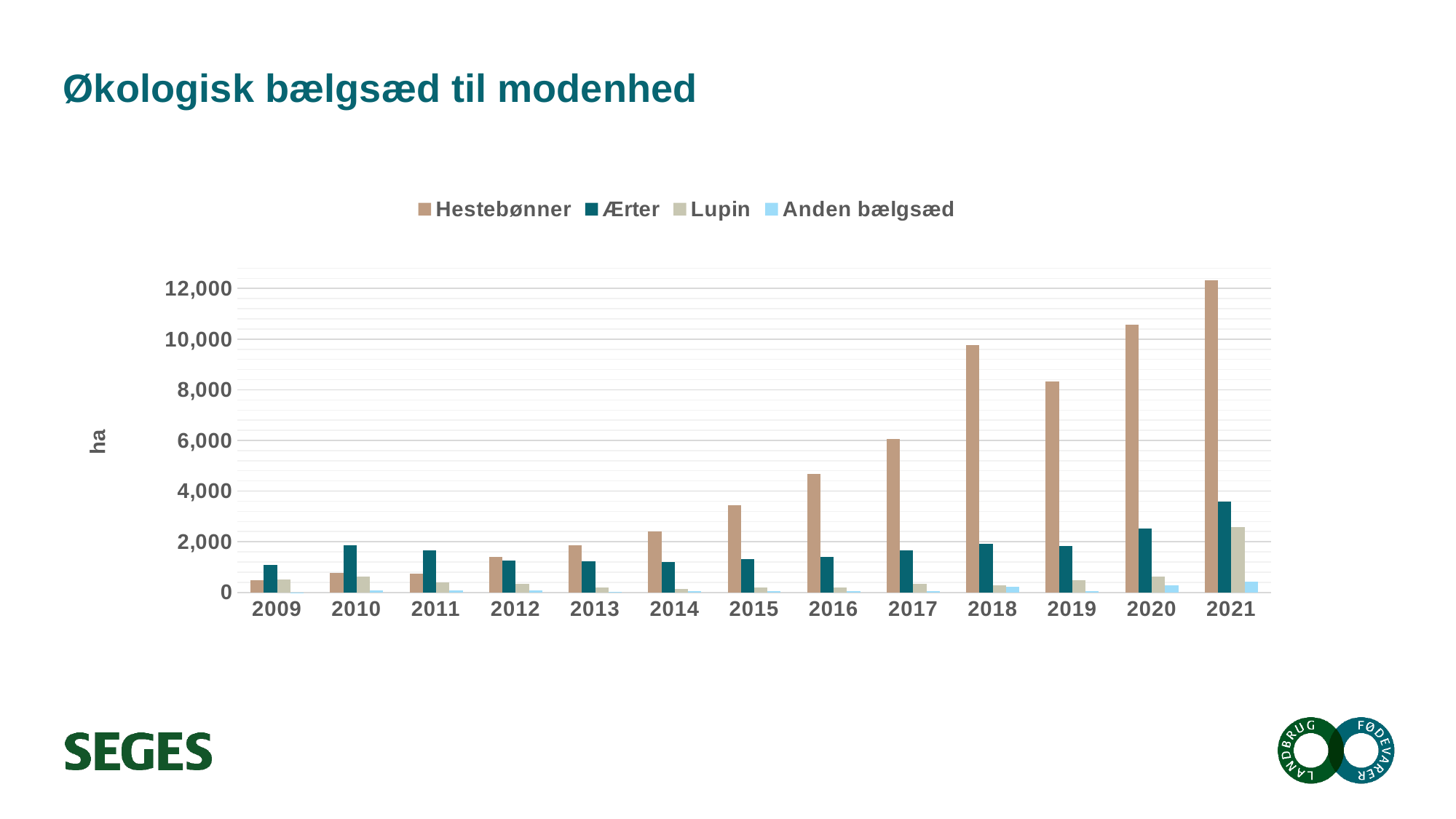
Is the value for Ærter in 2021 greater or less than 4,000? less Do the Hestebønner values rise or fall from 2011 to 2018? rise In which year is the Hestebønner bar highest? 2021 Is the value for Hestebønner in 2018 greater or less than 10,000? less What is the label on the y axis? ha In which year is the Hestebønner bar lowest? 2009 In 2021, which is larger: Hestebønner or Ærter? Hestebønner How many years are shown on the x axis? 13 How many series does the legend list? 4 What kind of chart is shown on the slide? bar chart In 2009, which is larger: Hestebønner or Ærter? Ærter Is the value for Hestebønner in 2021 greater or less than 12,000? greater